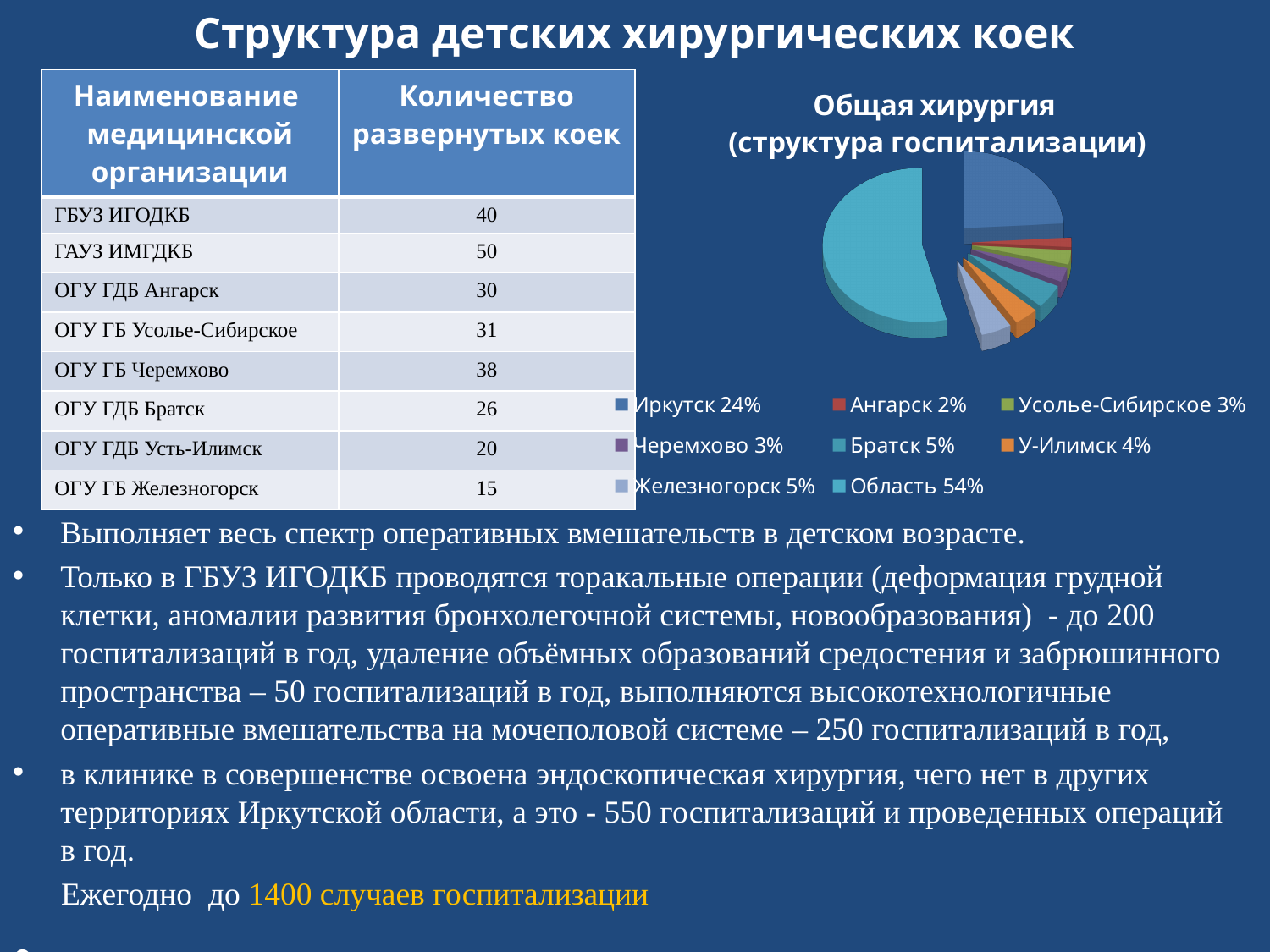
In the pie chart "Общая хирургия (структура госпитализации)", what share does Иркутск have? 24% In the pie chart "Общая хирургия (структура госпитализации)", what percentage is shown for Железногорск? 5% In the pie chart "Общая хирургия (структура госпитализации)", how many percentage points larger is the share of Область than the share of Иркутск? 30 In the pie chart "Общая хирургия (структура госпитализации)", which category has the smallest share? Ангарск In the pie chart "Общая хирургия (структура госпитализации)", what percentage is shown for Ангарск? 2% In the pie chart "Общая хирургия (структура госпитализации)", what percentage is shown for Братск? 5% How many categories does the legend of the pie chart "Общая хирургия (структура госпитализации)" list? 8 In the pie chart "Общая хирургия (структура госпитализации)", which has the larger share, Братск or У-Илимск? Братск In the pie chart "Общая хирургия (структура госпитализации)", which category has the largest share? Область What kind of chart is shown under the title "Общая хирургия (структура госпитализации)"? pie chart What is the title of the pie chart on the slide? Общая хирургия (структура госпитализации) In the pie chart "Общая хирургия (структура госпитализации)", what share does Область have? 54%